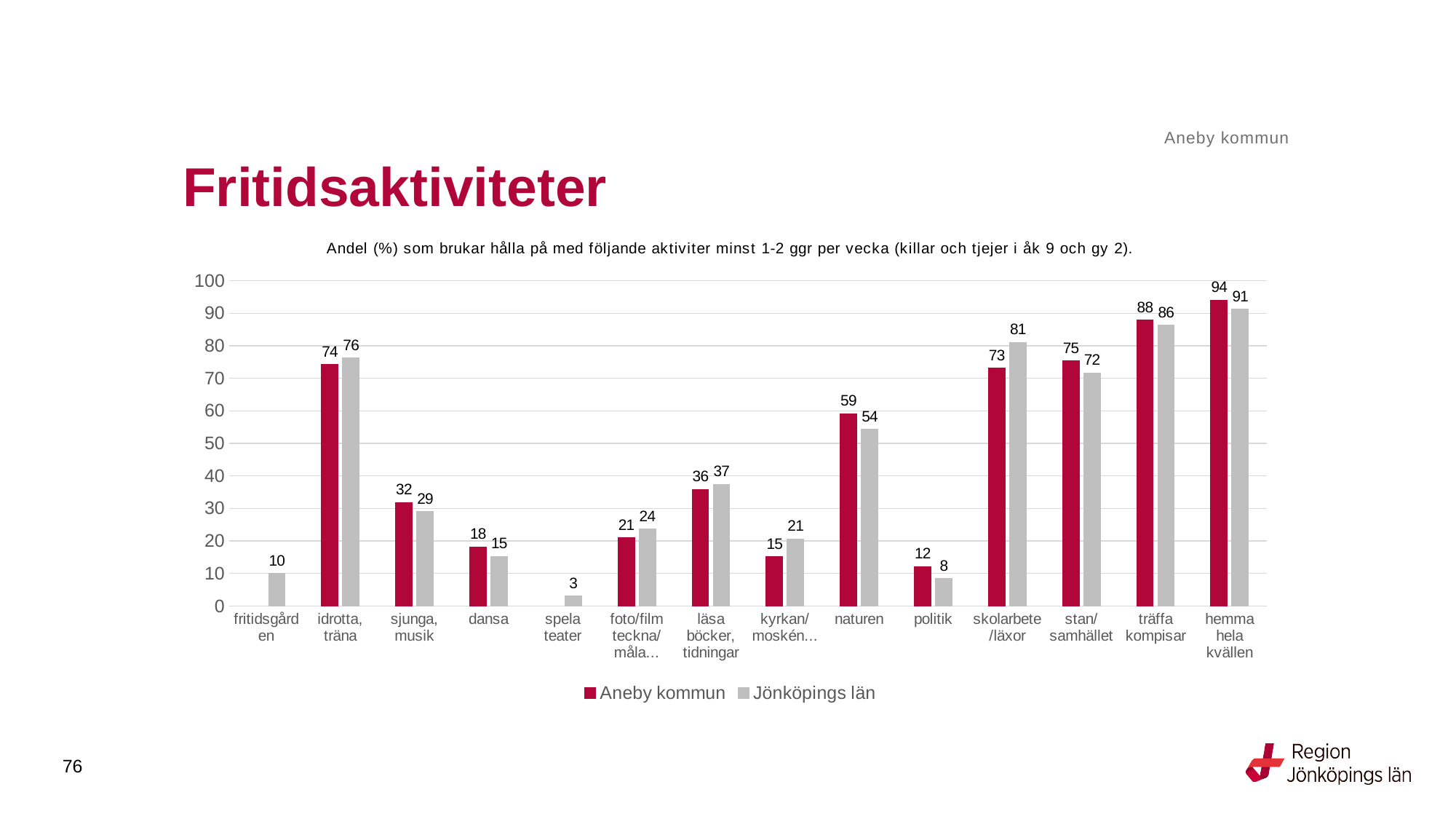
Which category has the highest value for Aneby kommun? hemma hela kvällen How many categories are shown on the x axis? 14 What is the value for Jönköpings län for 'skolarbete/läxor'? 81 Which is larger for 'politik': Aneby kommun or Jönköpings län? Aneby kommun What kind of chart is shown on the slide? bar chart Which series is shown in red? Aneby kommun What is the value for Aneby kommun for 'naturen'? 59 What is the difference between Jönköpings län and Aneby kommun for 'skolarbete/läxor'? 8 What is the value for Jönköpings län for 'spela teater'? 3 Which category has the lowest value for Jönköpings län? spela teater How many series does the legend list? 2 Which is larger for 'kyrkan/moskén…': Aneby kommun or Jönköpings län? Jönköpings län